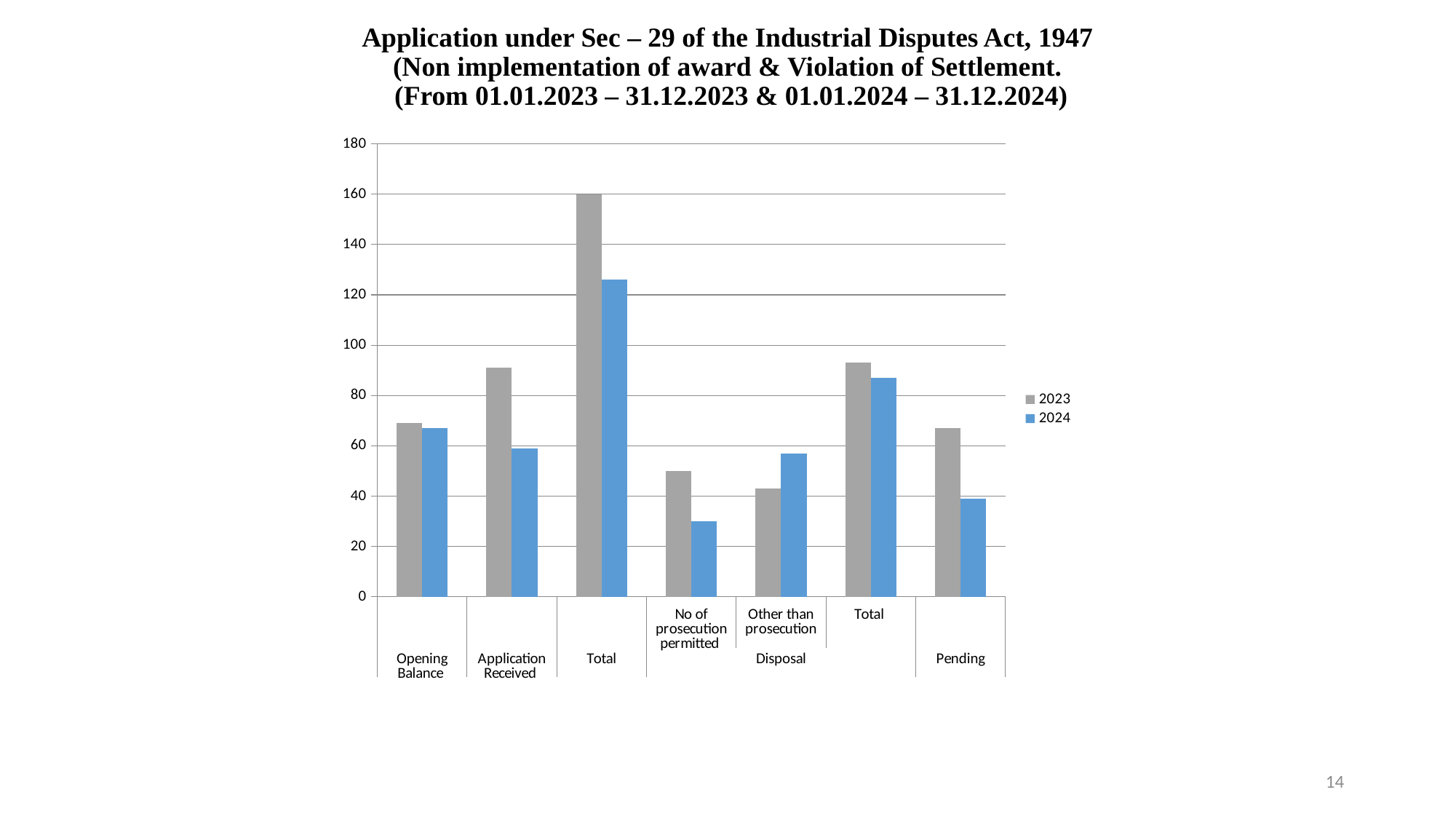
Which years are listed in the legend? 2023 and 2024 What type of chart is shown on the slide? Bar chart How many series does the legend list? 2 What is the value of the 2023 bar for Total (after Application Received)? 160 Is the 2024 value for Total (after Application Received) greater or less than 120? greater Is the 2024 value for No of prosecution permitted greater or less than 40? less Is the 2023 value for Application Received greater or less than 80? greater Which category has the lowest 2024 value? No of prosecution permitted Which category has the highest 2023 value? Total How many category groups are plotted along the x axis? 7 For Other than prosecution, which year has the larger value, 2023 or 2024? 2024 For Application Received, which year has the larger value, 2023 or 2024? 2023